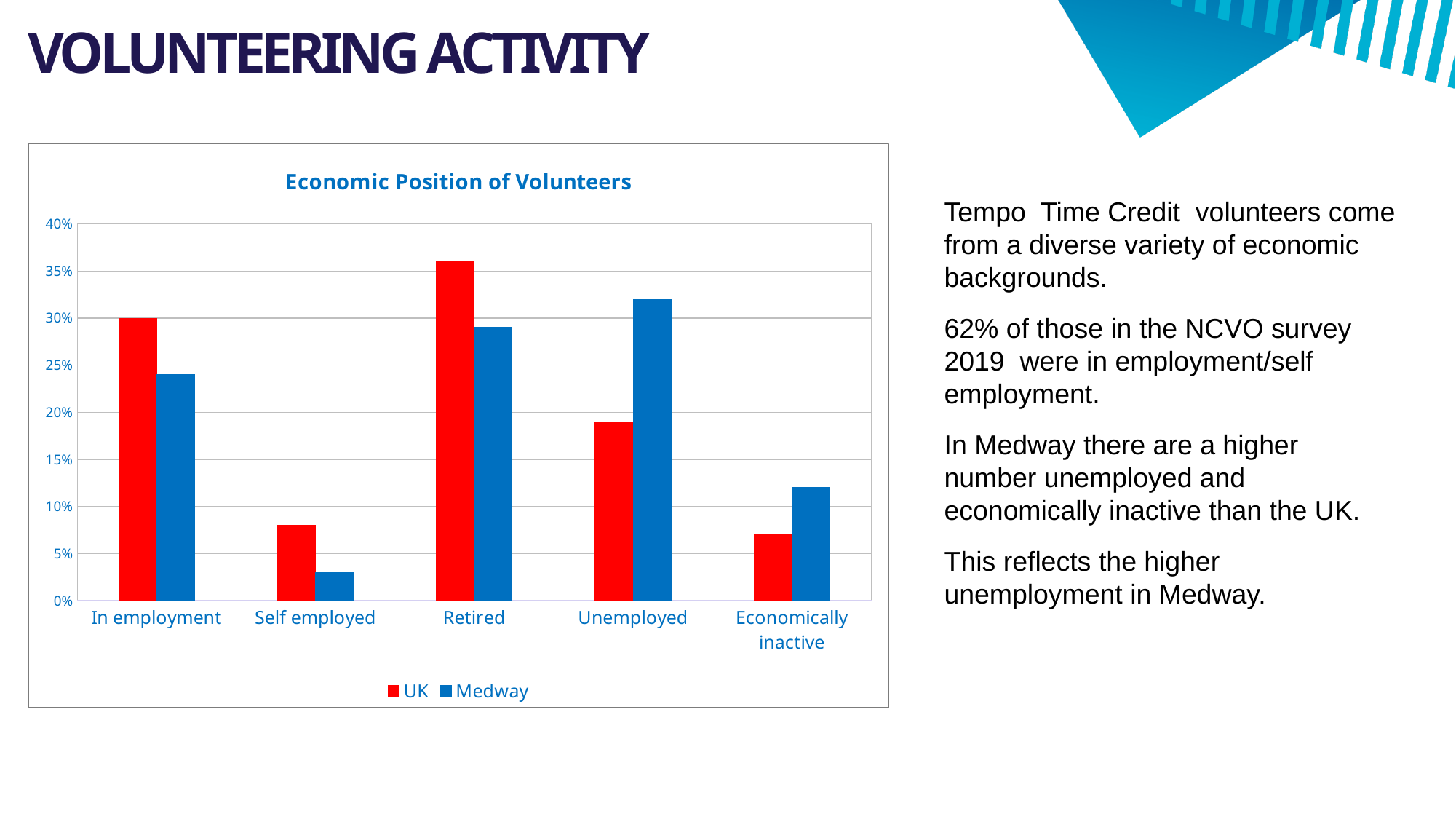
Is the Medway value for Self employed greater or less than 5%? less For Unemployed, which is larger, the UK value or the Medway value? Medway Which category has the lowest Medway value? Self employed What is the title of the chart? Economic Position of Volunteers For Retired, which is larger, the UK value or the Medway value? UK Is the Medway value for Unemployed greater or less than 30%? greater How many series does the chart legend list? 2 Which category has the highest UK value? Retired What type of chart is shown on the slide? bar chart What is the UK value for In employment? 30% How many economic position categories are shown on the x axis? 5 Which category has the highest Medway value? Unemployed